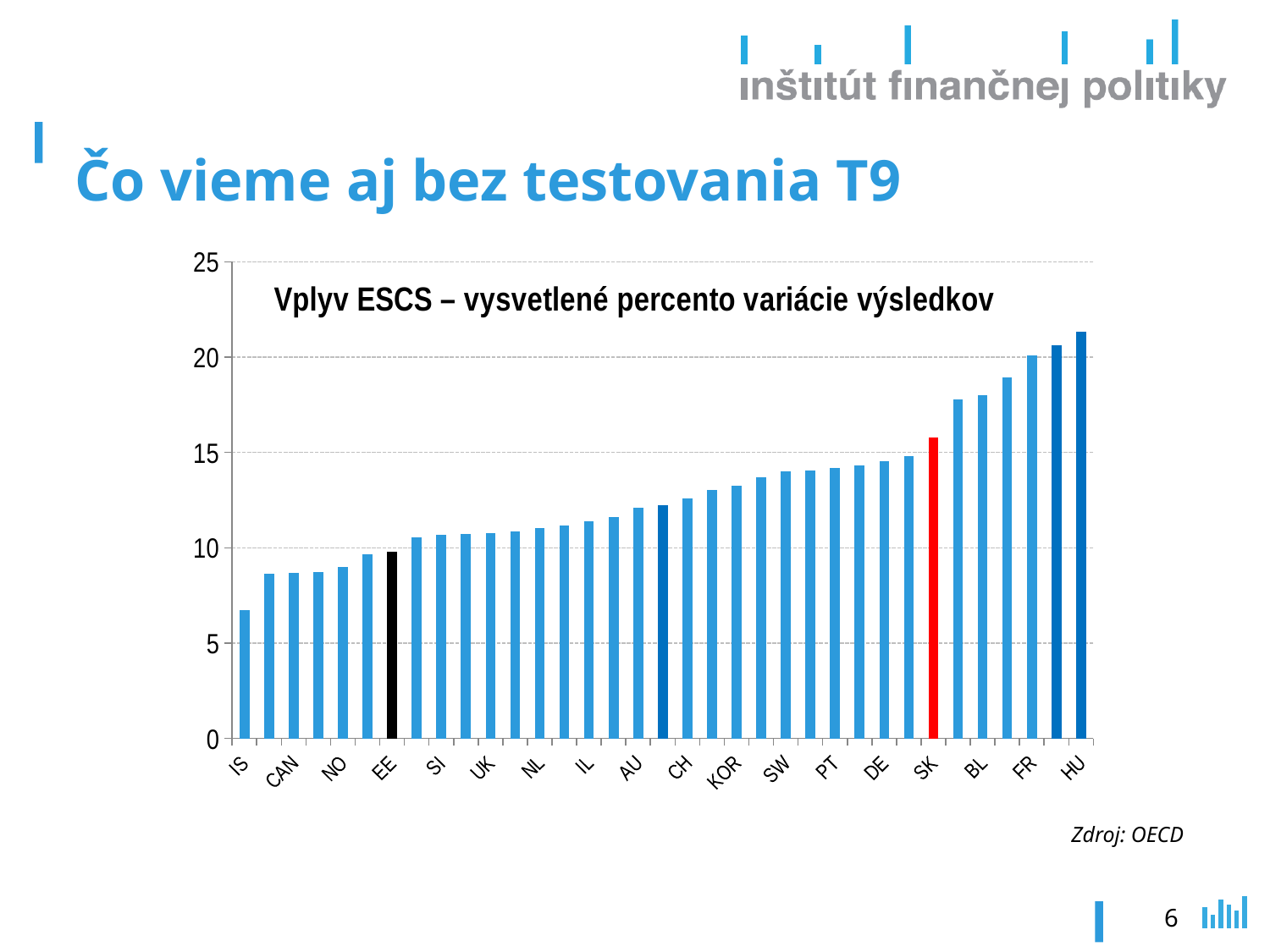
Which labelled country has the lowest value in the chart? IS Is the value for HU greater or less than 20? greater Is the value for IS greater or less than 10? less Do the values rise or fall from left to right along the x axis? rise Is the value for SK greater or less than 15? greater Which has the larger value, SK or DE? SK Which labelled country has the highest value in the chart? HU What is the title of the chart? Vplyv ESCS – vysvetlené percento variácie výsledkov What colour is the bar for SK? red What kind of chart is shown on the slide? bar chart